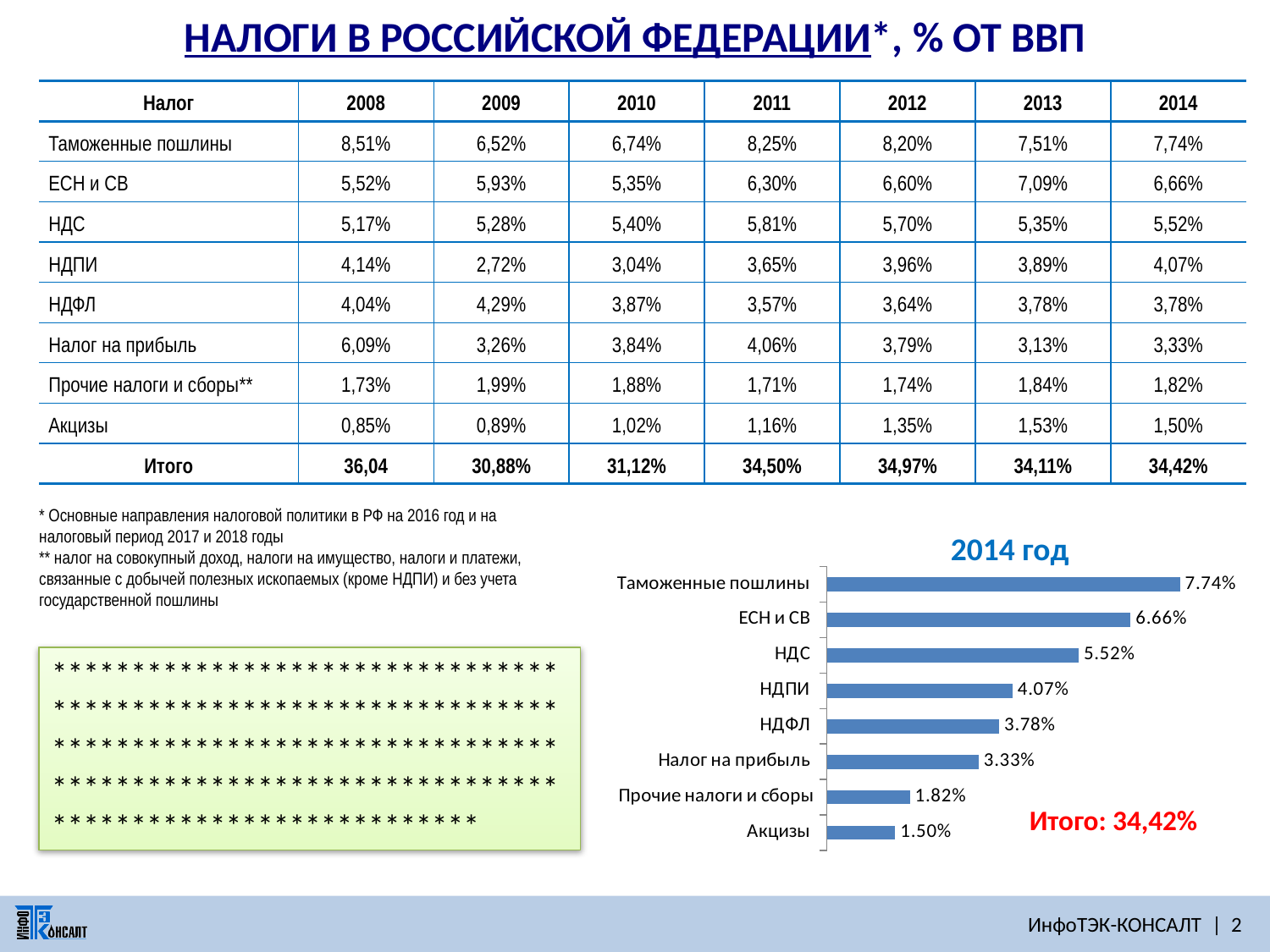
How many categories are shown in the 2014 год chart? 8 What total (Итого) is printed next to the 2014 год chart? 34,42% In the 2014 год chart, which is larger: НДФЛ or Прочие налоги и сборы? НДФЛ What is the title of the chart on the slide? 2014 год What is the value for НДПИ in the 2014 год chart? 4.07% What is the value for Таможенные пошлины in the 2014 год chart? 7.74% What is the value for Акцизы in the 2014 год chart? 1.50% In the 2014 год chart, what is the difference between НДС and Налог на прибыль? 2.19% Which category has the lowest value in the 2014 год chart? Акцизы What kind of chart is the 2014 год chart? Bar chart In the 2014 год chart, what is the difference between Таможенные пошлины and ЕСН и СВ? 1.08% Which category has the highest value in the 2014 год chart? Таможенные пошлины